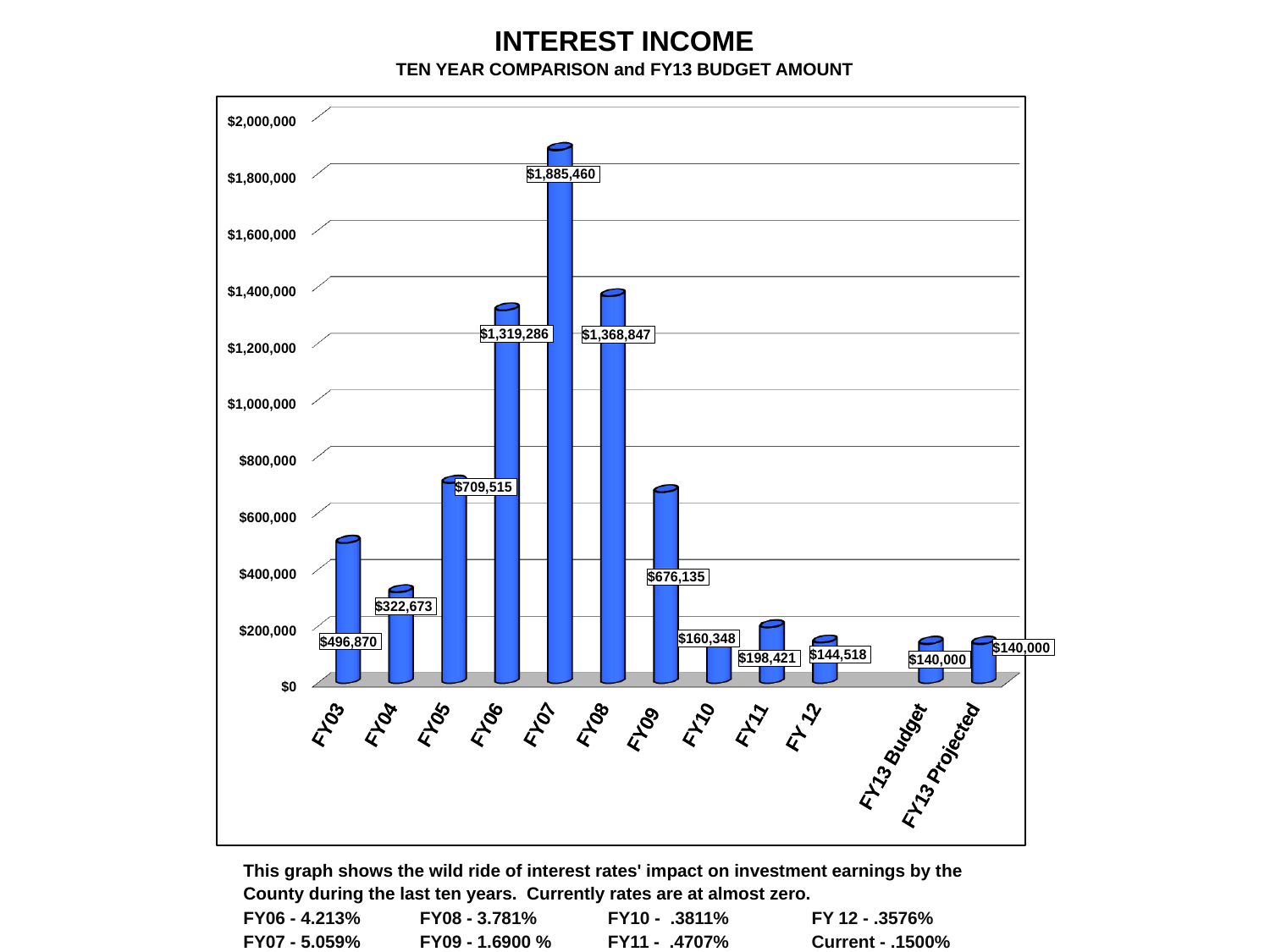
What is the difference between the FY05 and FY04 interest income values? $386,842 What is the interest income value for FY04? $322,673 What is the difference between the FY07 and FY08 interest income values? $516,613 What kind of chart is shown on the slide? bar chart Do the values rise or fall from FY07 through FY 12? fall How many categories are shown on the x axis? 12 Which of FY06 and FY08 has the larger interest income? FY08 Which fiscal year has the highest interest income? FY07 What is the value shown for FY13 Projected? $140,000 What is the subtitle of the chart? TEN YEAR COMPARISON and FY13 BUDGET AMOUNT Is the value for FY09 greater or less than $600,000? greater What is the interest income value for FY07? $1,885,460